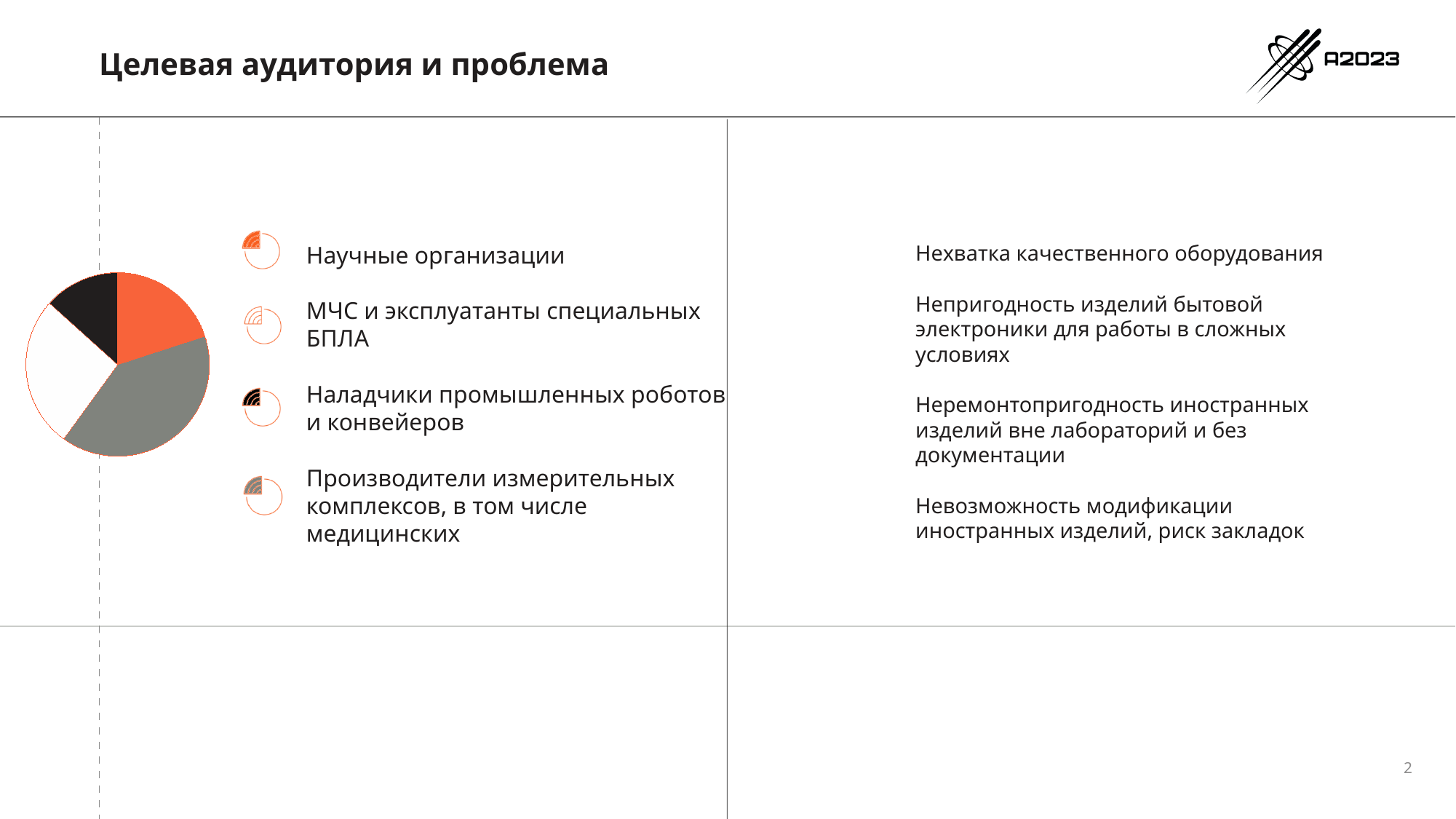
Which category has the smallest slice in the pie chart? Наладчики промышленных роботов и конвейеров Which slice is larger: Научные организации or Производители измерительных комплексов, в том числе медицинских? Производители измерительных комплексов, в том числе медицинских How many slices does the pie chart have? 4 Which slice is larger: Научные организации or МЧС и эксплуатанты специальных БПЛА? МЧС и эксплуатанты специальных БПЛА What colour is the slice for Наладчики промышленных роботов и конвейеров in the pie chart? black Which slice is larger: МЧС и эксплуатанты специальных БПЛА or Наладчики промышленных роботов и конвейеров? МЧС и эксплуатанты специальных БПЛА What kind of chart is shown on the slide? pie chart Which category has the largest slice in the pie chart? Производители измерительных комплексов, в том числе медицинских What colour is the slice for Научные организации in the pie chart? orange